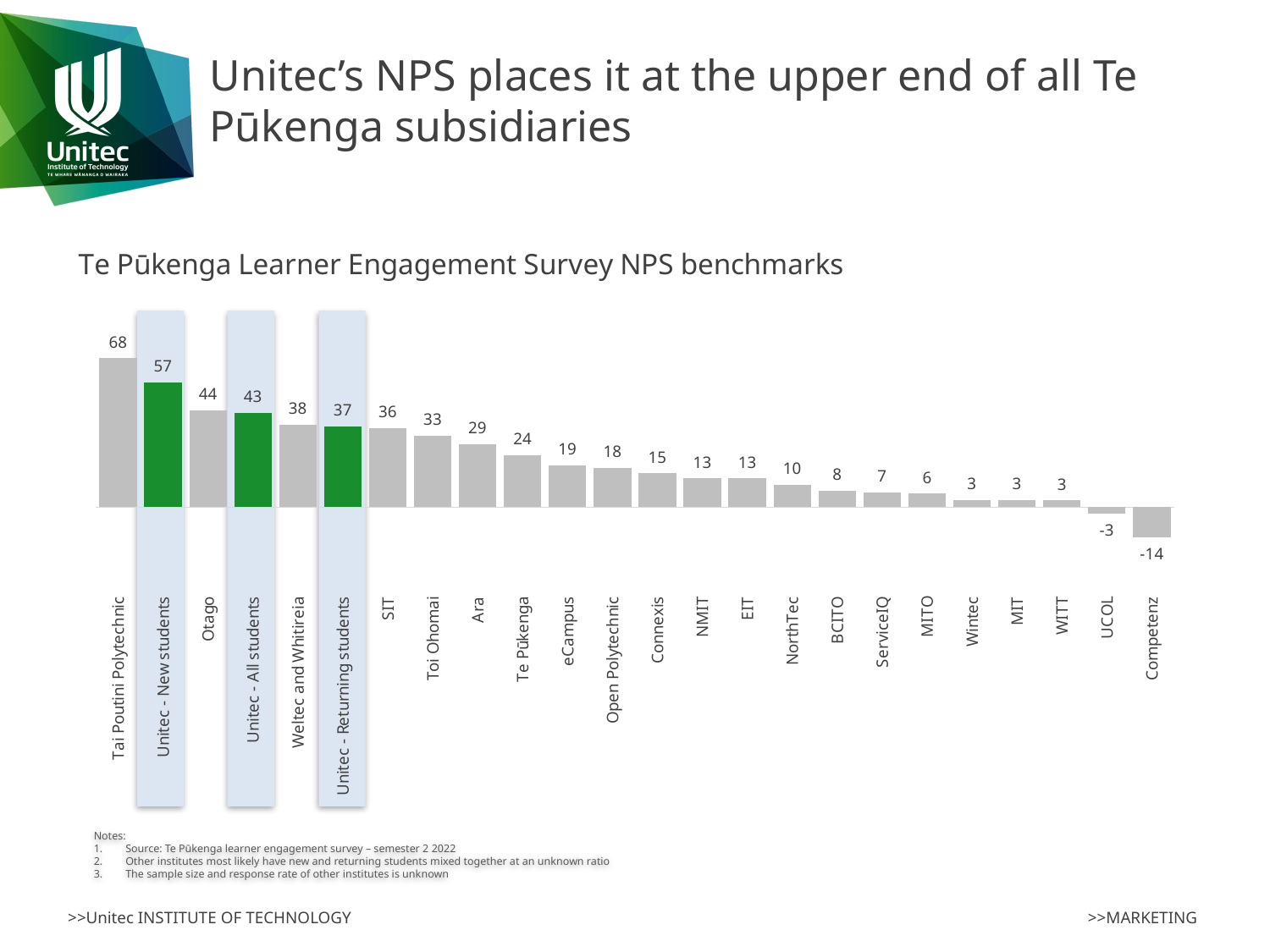
What is the title of the chart? Te Pūkenga Learner Engagement Survey NPS benchmarks Which institute has the lowest NPS on the chart? Competenz What is the NPS value for Unitec - All students? 43 How many institutes or groups are shown on the chart? 24 What is the NPS value for Te Pūkenga? 24 Which institute has the highest NPS on the chart? Tai Poutini Polytechnic What is the NPS value for Competenz? -14 What kind of chart is shown on the slide? Bar chart Which has a higher NPS, Otago or SIT? Otago What is the difference between the NPS for Unitec - New students and Unitec - Returning students? 20 What is the NPS value for Tai Poutini Polytechnic? 68 Do the NPS values rise or fall from left to right across the chart? Fall